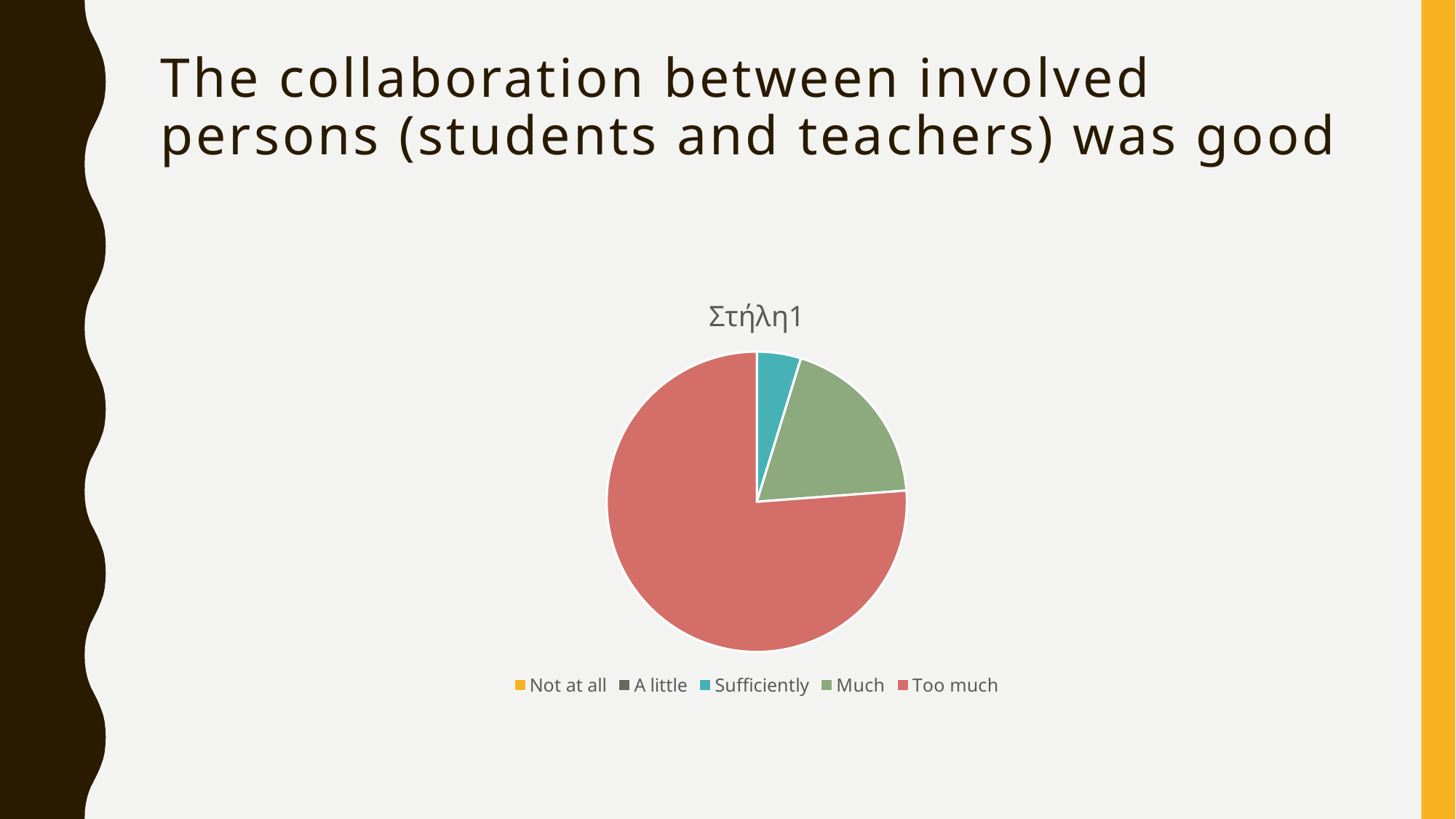
Which slice is larger, Too much or Much? Too much Which slice is larger, Much or Sufficiently? Much What is the title shown above the pie chart? Στήλη1 Does the Too much slice take up more or less than half of the pie? more Which of the visible slices is the smallest? Sufficiently Which category has the largest slice of the pie? Too much How many slices are visible in the pie? 3 What colour is the Too much slice? red How many entries does the legend list? 5 What kind of chart is shown on the slide? pie chart